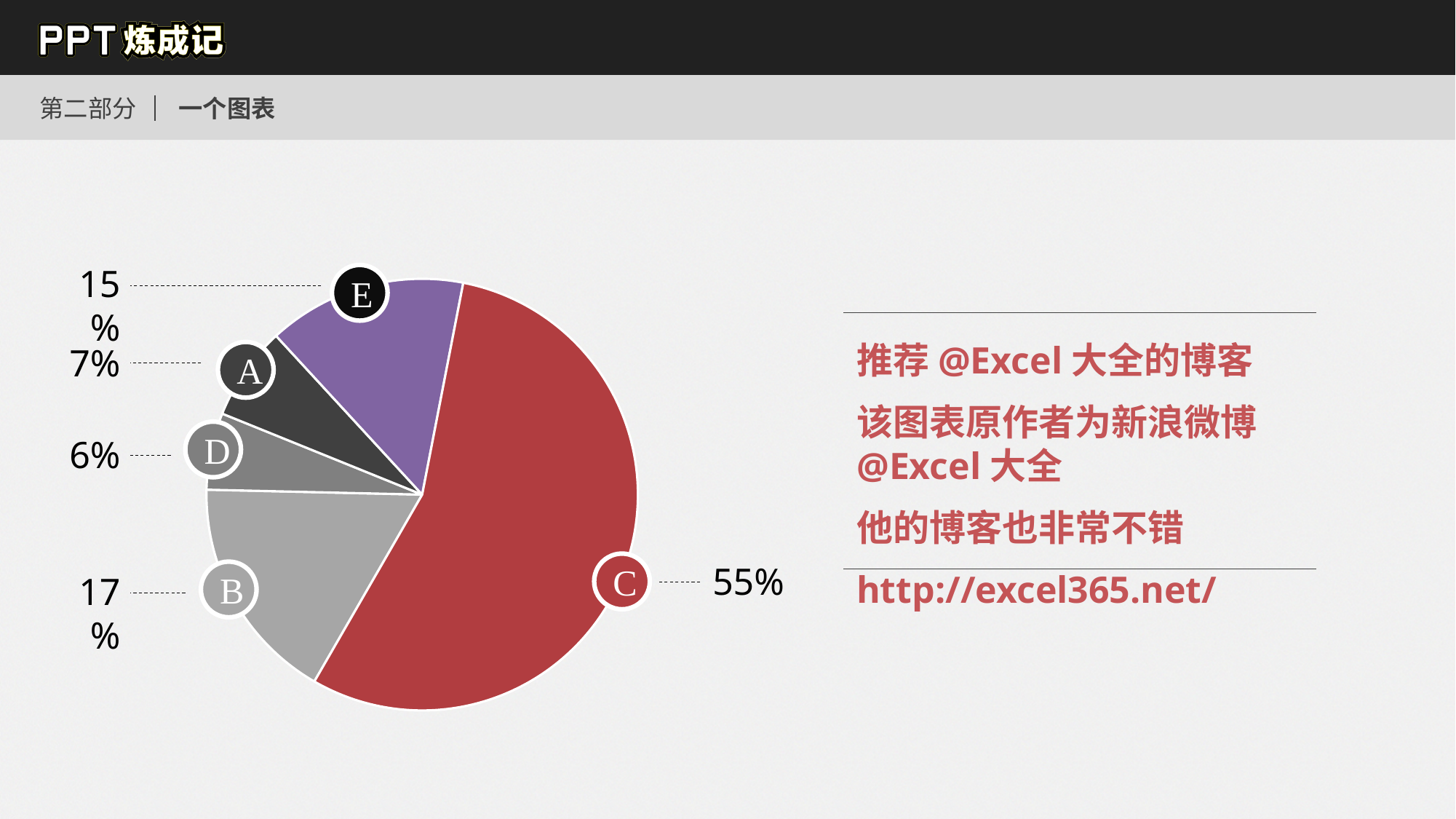
How many slices does the pie chart have? 5 What kind of chart is shown on the slide? pie chart Which slice has the smallest share of the pie? D Which is larger, slice A or slice E? E Which slice has the largest share of the pie? C What percentage is shown for slice D? 6% What percentage is shown for slice B? 17% What percentage is shown for slice C? 55% What is the combined percentage of slices A and D? 13% What percentage is shown for slice E? 15% What is the difference in percentage points between slice C and slice B? 38 What colour is slice C in the pie chart? red